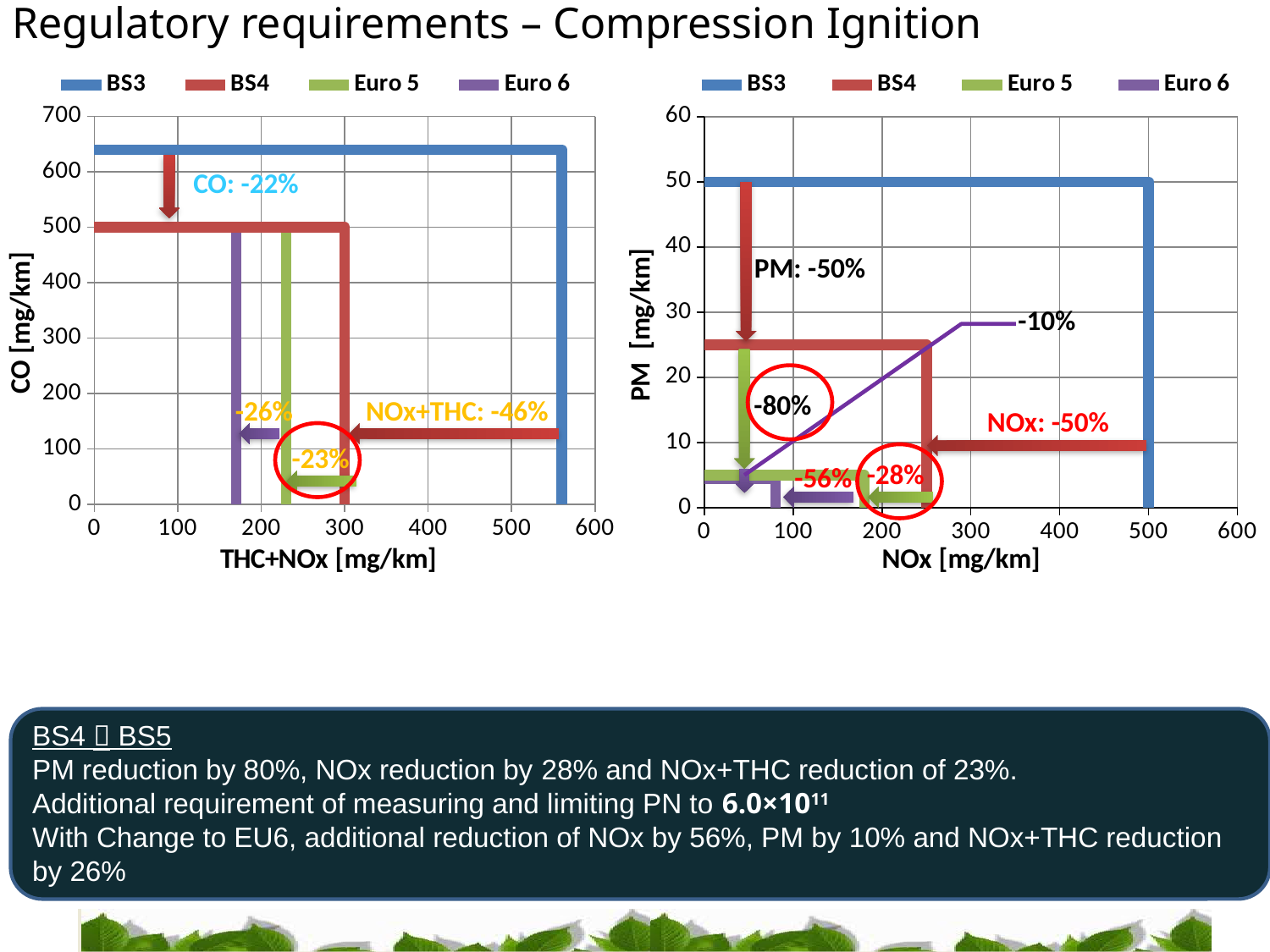
What kind of chart is the right chart (PM vs NOx)? line chart In the left chart, is the Euro 6 THC+NOx limit greater or less than 200 mg/km? less In the left chart, is the BS3 CO limit greater or less than 600 mg/km? greater In the left chart, which series has the highest CO limit? BS3 In the right chart, is the BS3 PM limit greater or less than 40 mg/km? greater What is the x-axis title of the right chart? NOx [mg/km] How many series does the legend of the left chart (CO vs THC+NOx) list? 4 In the left chart, what CO reduction percentage is annotated between BS3 and BS4? -22% In the right chart, what PM reduction percentage is annotated between BS3 and BS4? -50% In the right chart, which series has the lowest NOx limit? Euro 6 In the left chart, what NOx+THC reduction percentage is annotated between BS3 and BS4? -46%